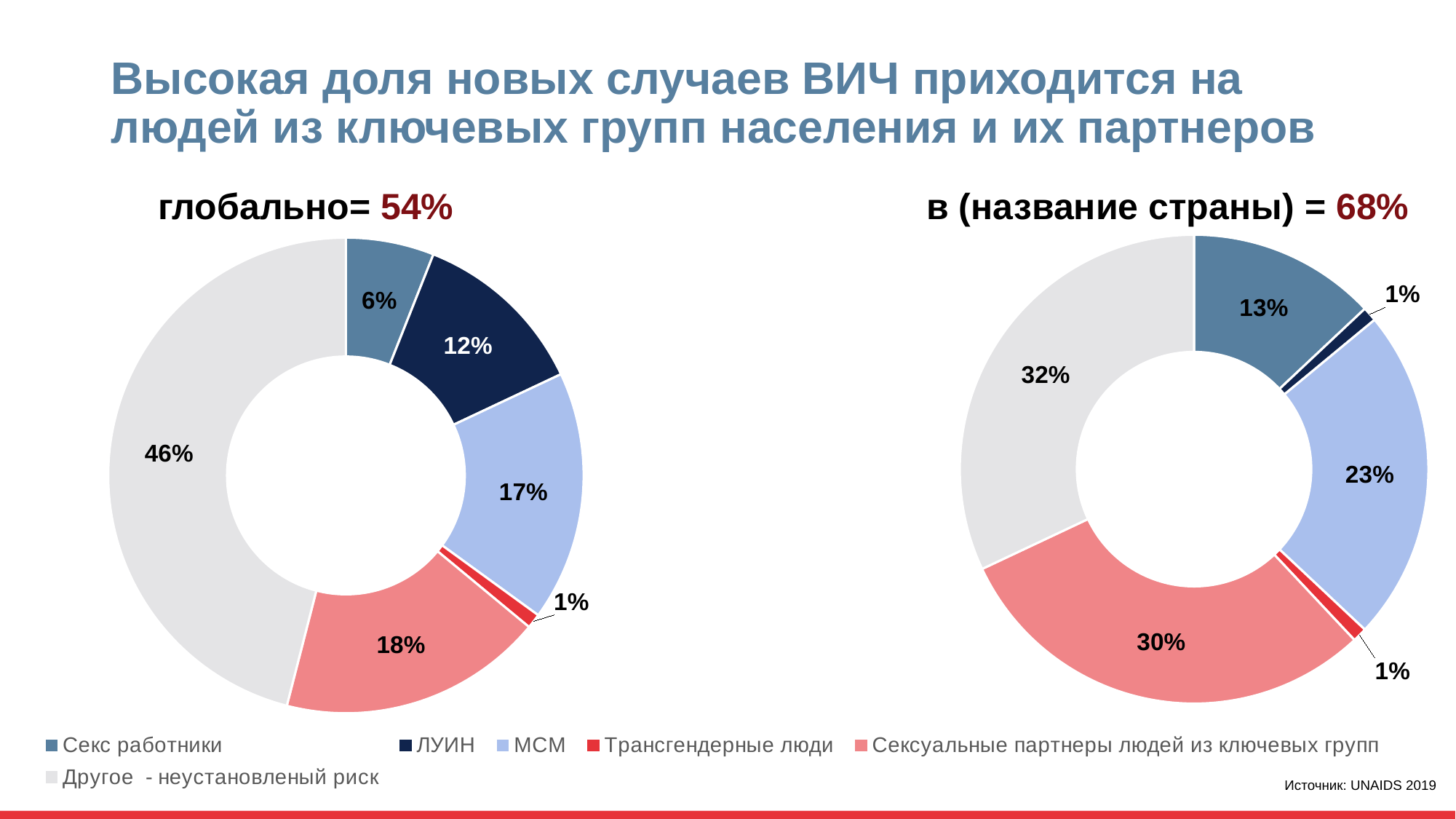
What is the source cited at the bottom of the slide? UNAIDS 2019 In the right chart (в (название страны) = 68%), what is the difference between the МСМ slice and the Секс работники slice? 10% Which chart shows a larger share for ЛУИН, the left (глобально) or the right (в (название страны))? the left (глобально) In the left chart (глобально= 54%), what is the difference between the Сексуальные партнеры людей из ключевых групп slice and the ЛУИН slice? 6% In the right chart (в (название страны) = 68%), what share is labelled for Секс работники? 13% In the left chart (глобально= 54%), what share is labelled for the МСМ slice? 17% In the right chart (в (название страны) = 68%), which category has the largest slice? Другое - неустановленый риск In the left chart (глобально= 54%), what share is labelled for Другое - неустановленый риск? 46% How many categories does the legend list? 6 In the right chart (в (название страны) = 68%), what share is labelled for Сексуальные партнеры людей из ключевых групп? 30% In the left chart (глобально= 54%), which category has the largest slice? Другое - неустановленый риск What kind of chart is used on this slide? pie (donut) chart